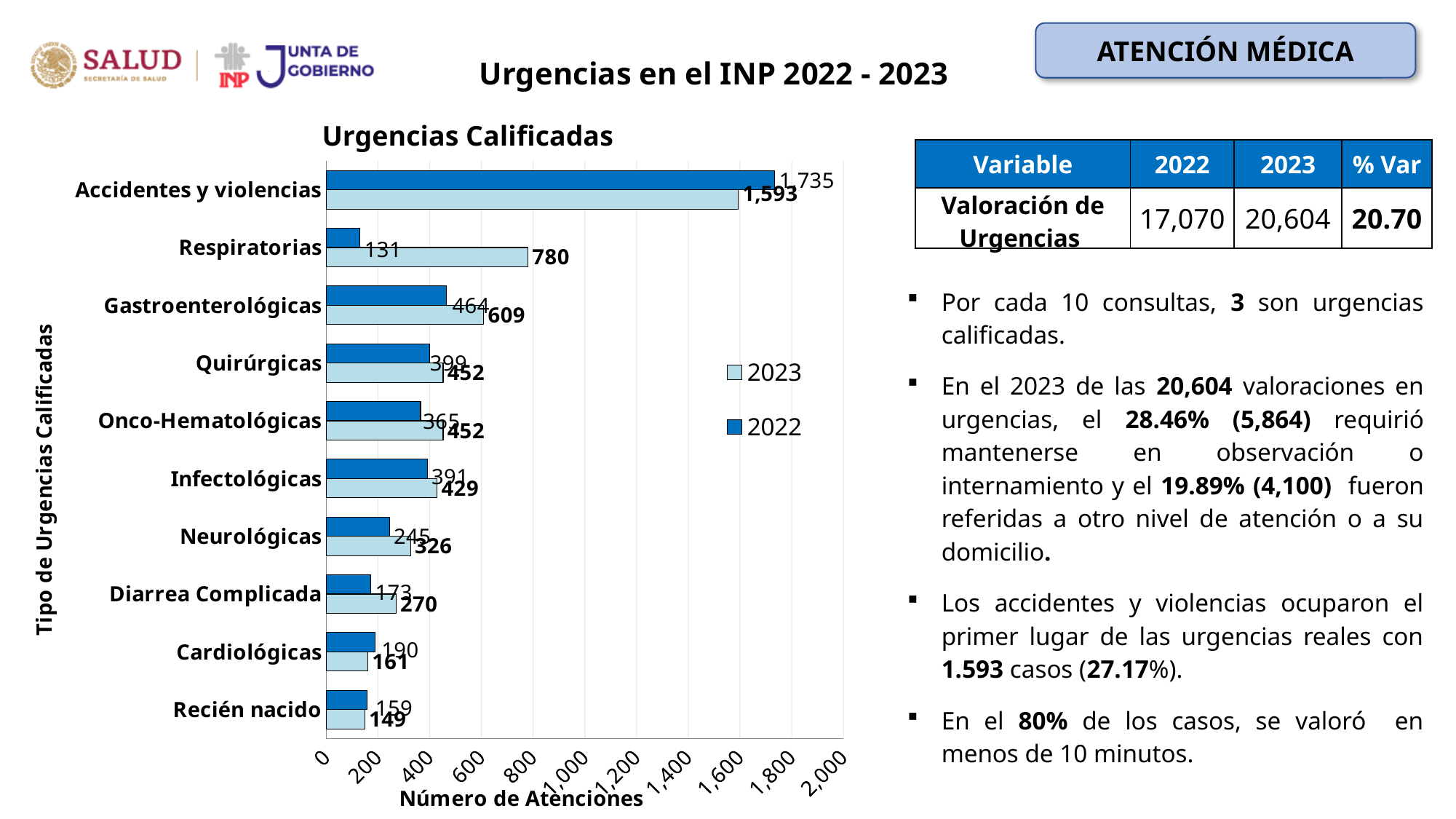
What is the x-axis title of the 'Urgencias Calificadas' chart? Número de Atenciones In the 'Urgencias Calificadas' chart, which is larger for 'Cardiológicas': the 2022 value or the 2023 value? 2022 What is the 2022 value for 'Accidentes y violencias' in the 'Urgencias Calificadas' chart? 1,735 Which category has the highest 2023 value in the 'Urgencias Calificadas' chart? Accidentes y violencias What is the 2023 value for 'Accidentes y violencias' in the 'Urgencias Calificadas' chart? 1,593 How many categories of urgencias are plotted on the 'Urgencias Calificadas' chart? 10 Which category has the lowest 2023 value in the 'Urgencias Calificadas' chart? Recién nacido How many series does the legend of the 'Urgencias Calificadas' chart list? 2 What is the 2022 value for 'Gastroenterológicas' in the 'Urgencias Calificadas' chart? 464 What type of chart is shown under the title 'Urgencias Calificadas'? bar chart What is the 2023 value for 'Respiratorias' in the 'Urgencias Calificadas' chart? 780 In the 'Urgencias Calificadas' chart, what is the difference between the 2023 and 2022 values for 'Respiratorias'? 649